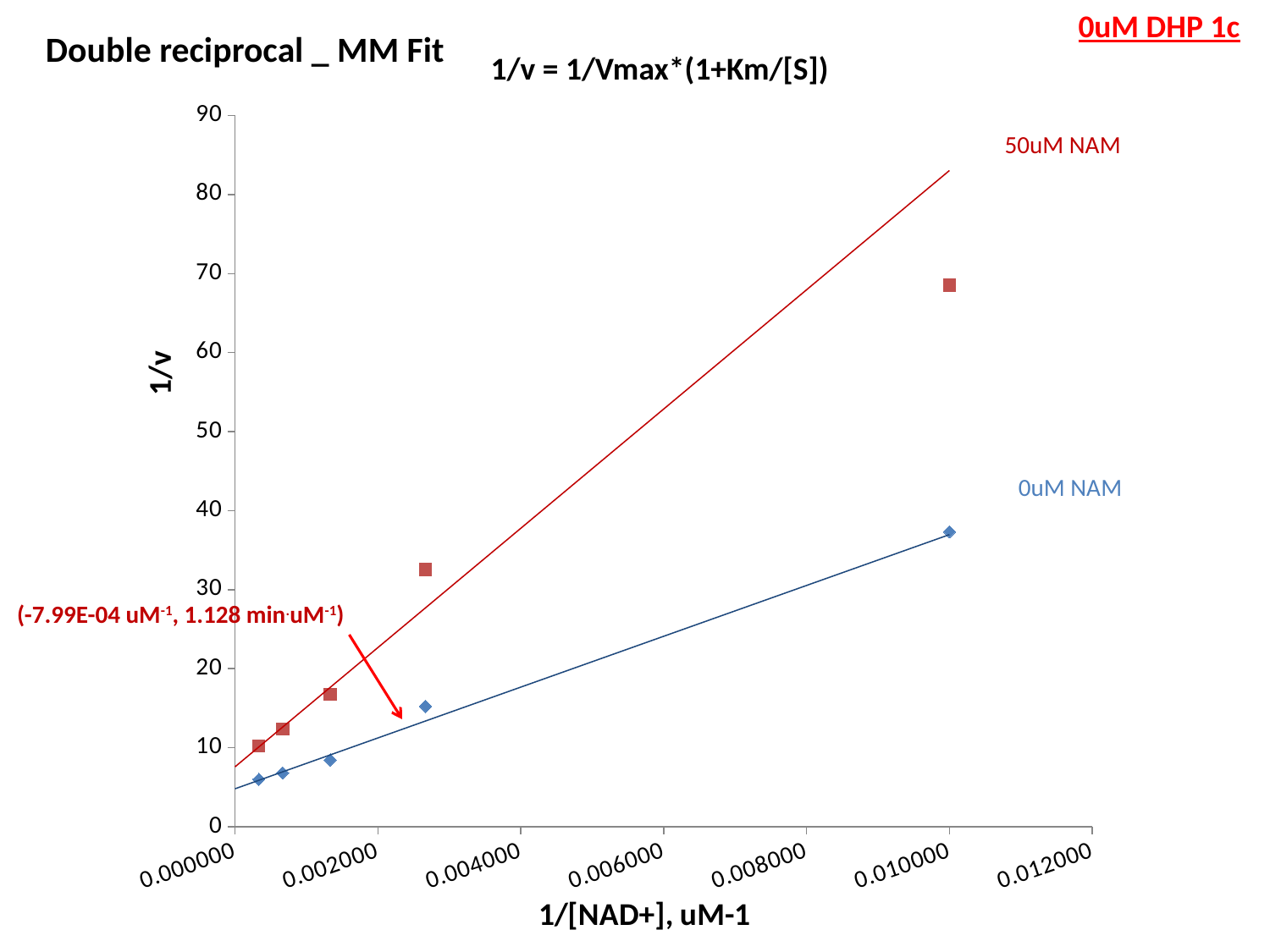
What kind of chart is shown on the slide? Scatter chart At the highest 1/[NAD+] value plotted, which series has the larger 1/v value, 50uM NAM or 0uM NAM? 50uM NAM What is the label of the x axis? 1/[NAD+], uM-1 What is the title of the chart? Double reciprocal _ MM Fit How many data points are plotted for the 0uM NAM series? 5 Is the 1/v value of the 50uM NAM point at about 0.010 uM-1 greater or less than 60? greater Which series contains the point with the highest 1/v value on the chart? 50uM NAM Is the 1/v value of the 50uM NAM point near 0.0027 uM-1 greater or less than 30? greater How many data points are plotted for the 50uM NAM series? 5 Is the 1/v value of the 0uM NAM point at about 0.010 uM-1 greater or less than 40? less Do the 1/v values for the 50uM NAM series rise or fall as 1/[NAD+] increases? Rise